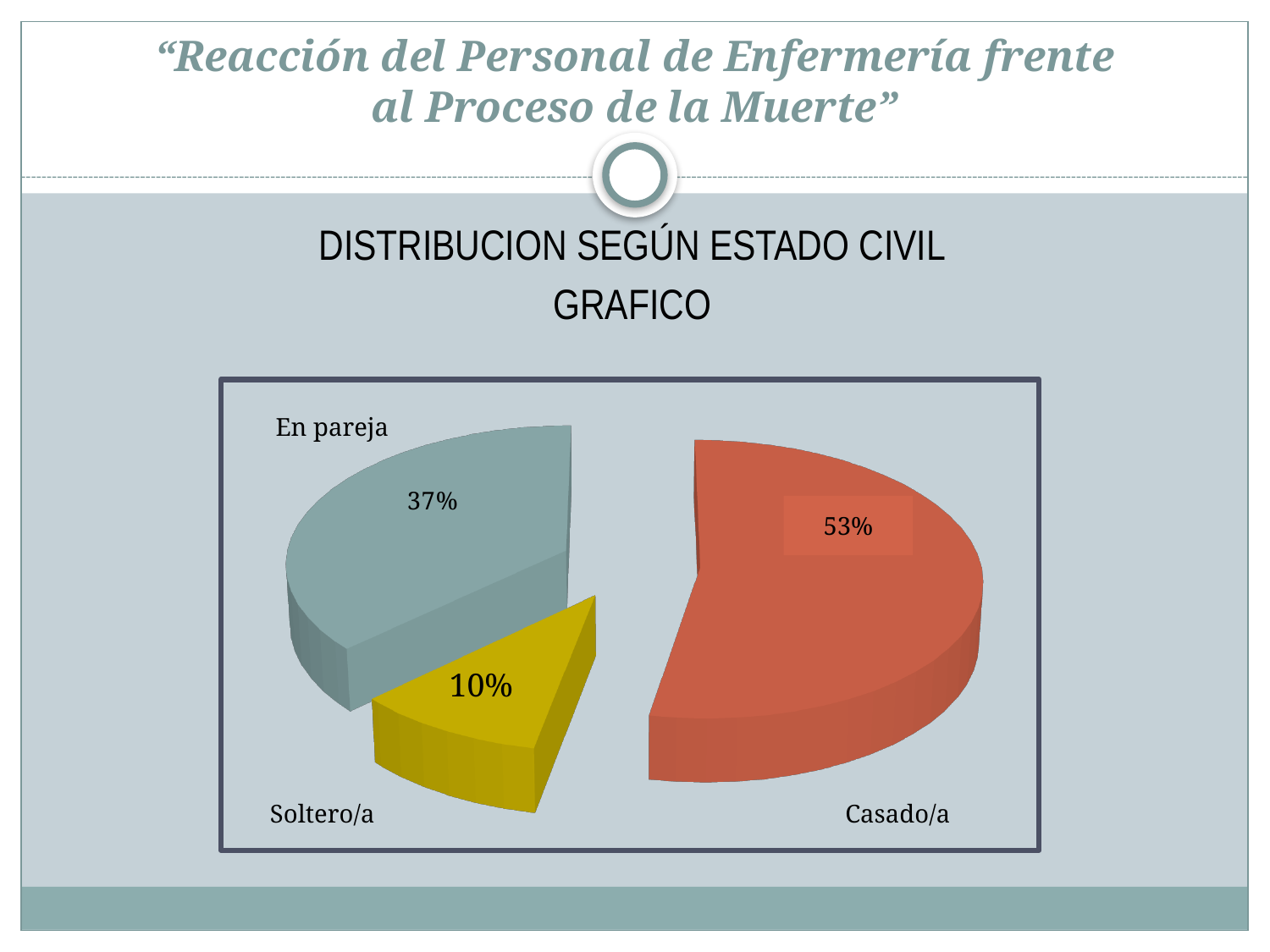
What colour is the Soltero/a slice of the pie chart? Yellow Which is larger, the share for En pareja or the share for Soltero/a? En pareja Which category has the largest share of the pie chart? Casado/a What percentage of the pie chart corresponds to Soltero/a? 10% What is the title of the distribution shown on the slide? DISTRIBUCION SEGÚN ESTADO CIVIL What percentage of the pie chart corresponds to En pareja? 37% What kind of chart is shown on the slide? Pie chart Which category has the smallest share of the pie chart? Soltero/a What percentage of the pie chart corresponds to Casado/a? 53% What is the difference in percentage points between Casado/a and En pareja? 16 How many categories are shown in the pie chart? 3 What is the difference in percentage points between En pareja and Soltero/a? 27